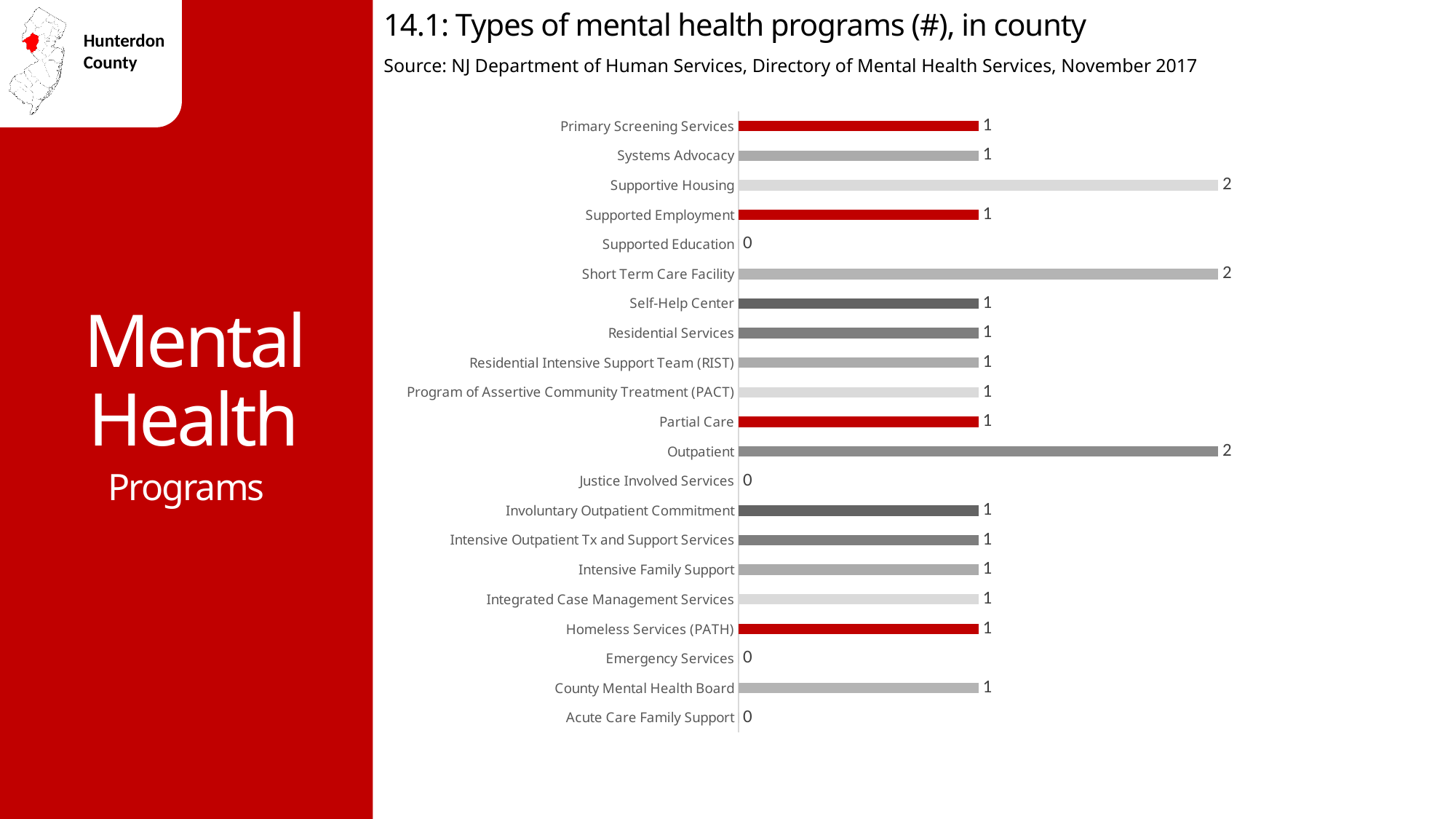
What is the value for Supported Education? 0 What is the value for Supportive Housing? 2 What is the value for Outpatient? 2 Which has a larger value, County Mental Health Board or Acute Care Family Support? County Mental Health Board What is the value for Homeless Services (PATH)? 1 What is the highest value shown on the chart? 2 What is the title of the chart? 14.1: Types of mental health programs (#), in county Which has a larger value, Outpatient or Self-Help Center? Outpatient What is the value for Emergency Services? 0 What kind of chart is shown on the slide? Bar chart How many categories are shown on the chart? 21 What is the difference between the values for Short Term Care Facility and Partial Care? 1